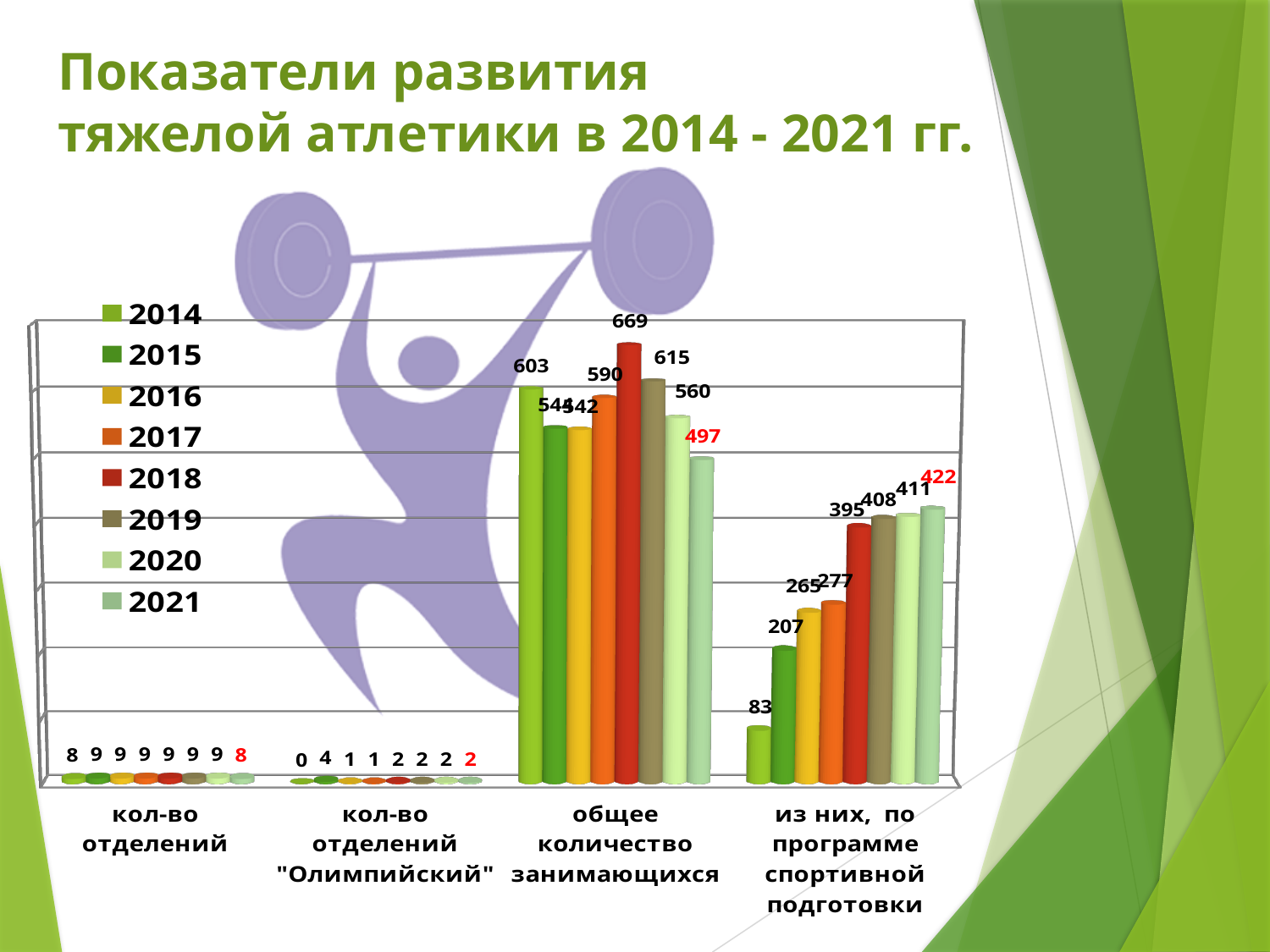
What is the difference between the 2018 and 2021 values in the category "общее количество занимающихся"? 172 What is the value for 2021 in the category "кол-во отделений"? 8 How many series does the legend list? 8 What is the value for 2015 in the category "кол-во отделений "Олимпийский""? 4 What is the value for 2018 in the category "общее количество занимающихся"? 669 Which year has the lowest value in the category "из них, по программе спортивной подготовки"? 2014 Which year has the highest value in the category "общее количество занимающихся"? 2018 How many categories are shown on the x axis of the chart? 4 In the category "общее количество занимающихся", which is larger: the value for 2019 or the value for 2020? 2019 What is the value for 2014 in the category "из них, по программе спортивной подготовки"? 83 Do the values in the category "из них, по программе спортивной подготовки" rise or fall from 2014 to 2021? rise What is the difference between the 2021 and 2014 values in the category "из них, по программе спортивной подготовки"? 339